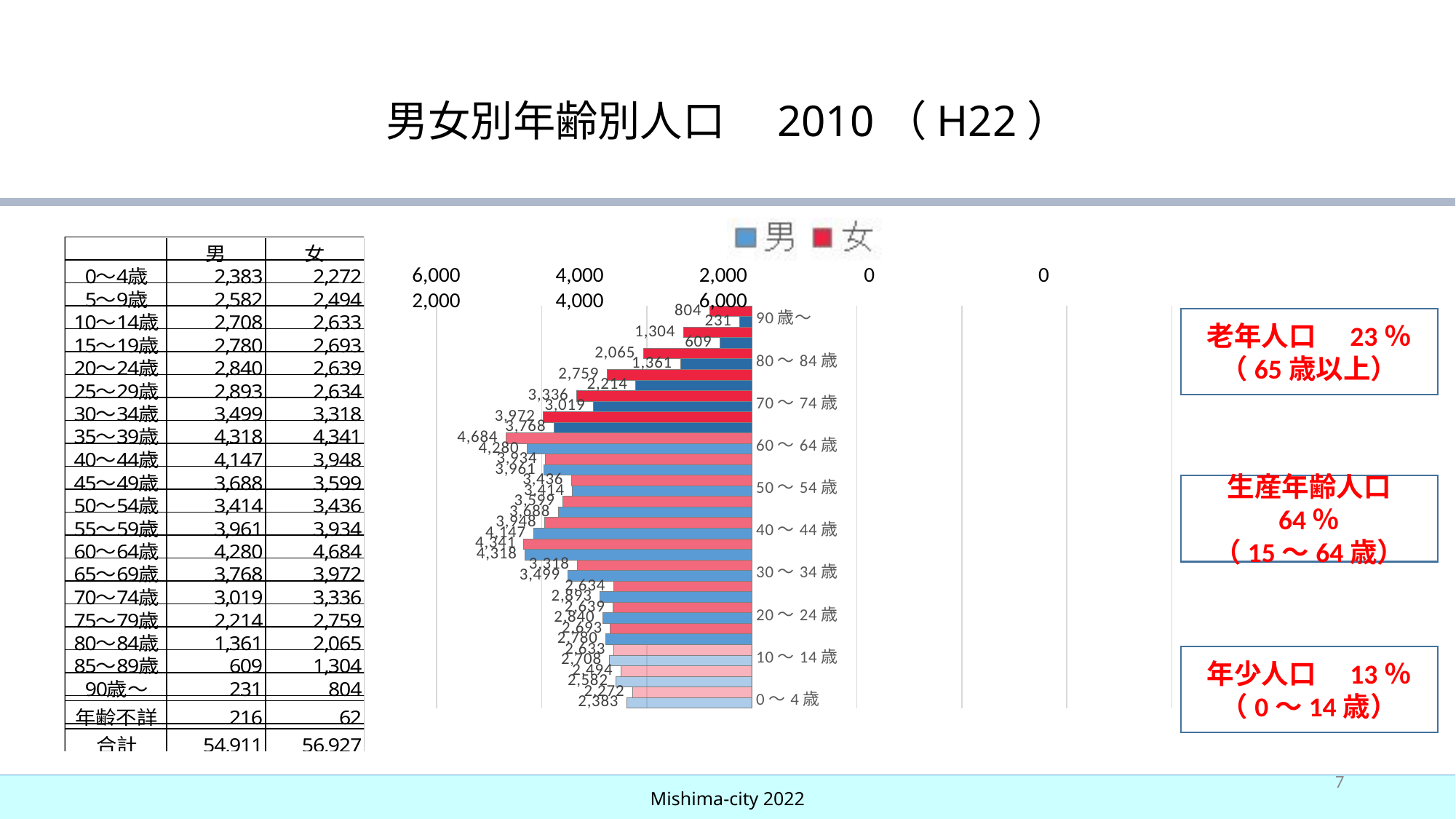
What are the two series named in the chart legend? 男 and 女 How many series does the chart legend list? 2 What is the value for 女 in the 60〜64歳 age group? 4,684 What is the value for 男 in the 0〜4歳 age group? 2,383 In the 80〜84歳 age group, which is larger, 男 or 女? 女 What type of chart is shown on the slide? bar chart What is the difference between 女 and 男 in the 60〜64歳 age group? 404 Which colour represents 男 in the chart? blue What is the value for 男 in the 90歳〜 age group? 231 Which age group has the lowest value for 男? 90歳〜 Which age group has the highest value for 女? 60〜64歳 Is the value for 男 in the 60〜64歳 age group greater or less than 4,000? greater